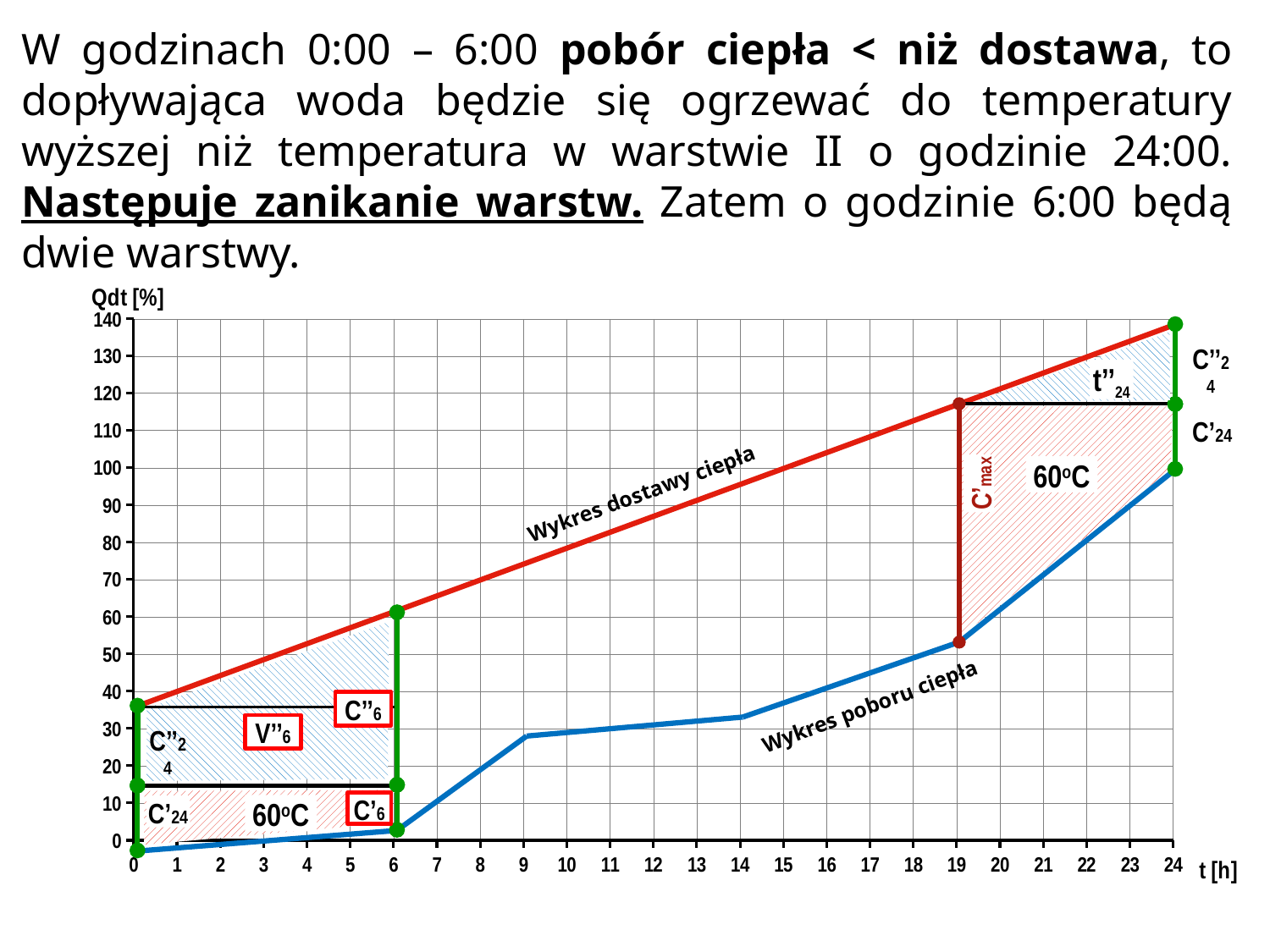
Is the value of the 'Wykres dostawy ciepła' line at t = 19 greater or less than 110? greater What is the label of the red line on the chart? Wykres dostawy ciepła Is the value of the 'Wykres dostawy ciepła' line at t = 0 greater or less than 30? greater Is the value of the 'Wykres dostawy ciepła' line at t = 24 greater or less than 130? greater Does the 'Wykres dostawy ciepła' line rise or fall as t increases from 0 to 24? rise What kind of chart is shown on the slide? line chart Does the 'Wykres poboru ciepła' line rise or fall as t increases from 0 to 24? rise At t = 12, which line has the higher value: 'Wykres dostawy ciepła' or 'Wykres poboru ciepła'? Wykres dostawy ciepła What is the label of the blue line on the chart? Wykres poboru ciepła How many data lines are plotted on the chart? 2